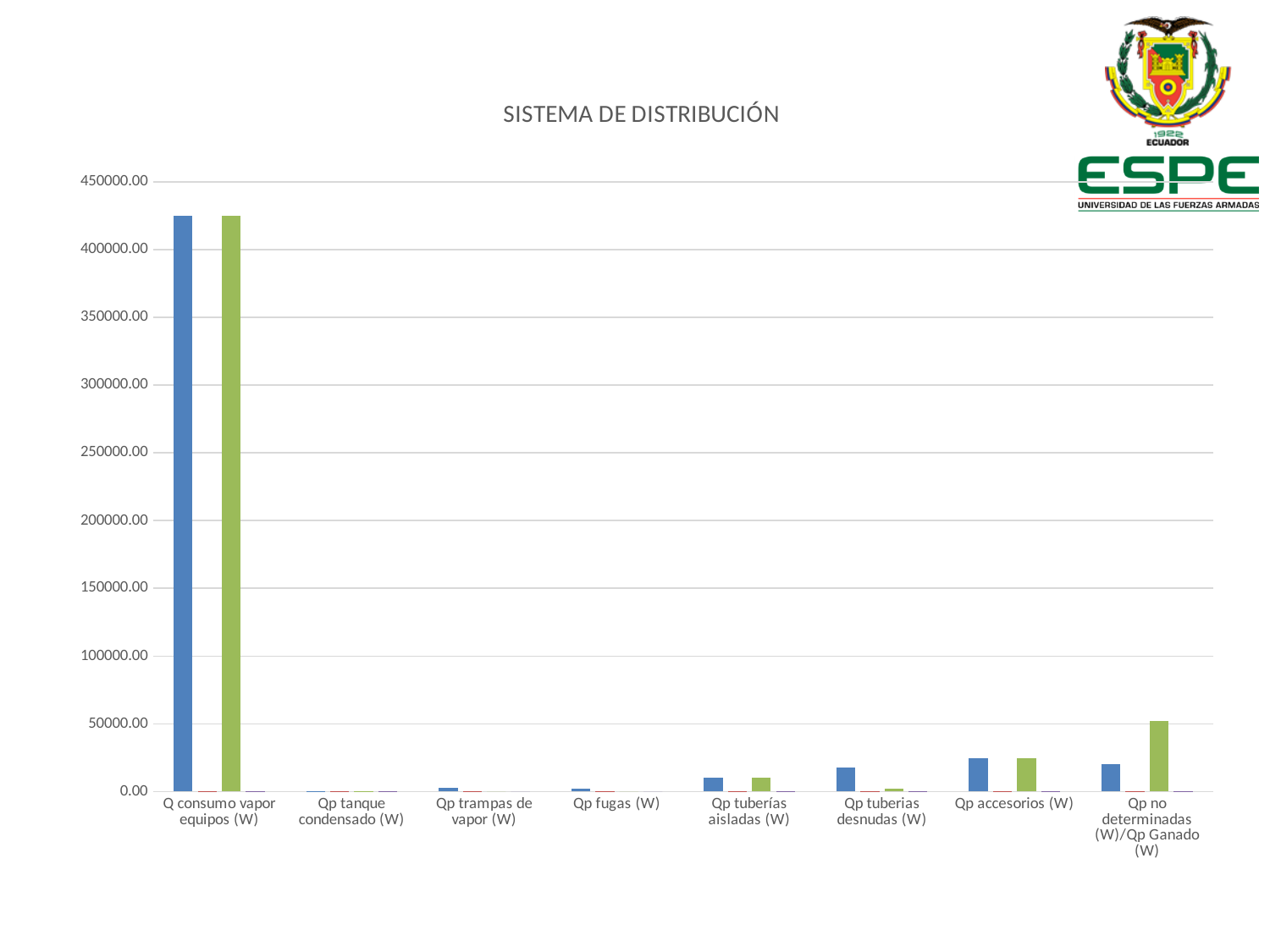
Which is larger: the green bar for Qp no determinadas (W)/Qp Ganado (W) or the green bar for Qp accesorios (W)? Qp no determinadas (W)/Qp Ganado (W) Is the blue bar for Qp accesorios (W) greater or less than 50000.00? less How many categories are shown on the x axis of the chart? 8 Which is larger: the blue bar for Qp accesorios (W) or the blue bar for Qp tuberías aisladas (W)? Qp accesorios (W) Is the green bar for Q consumo vapor equipos (W) greater or less than 400000.00? greater What is the title of the chart? SISTEMA DE DISTRIBUCIÓN Is the blue bar for Qp tuberías aisladas (W) greater or less than 50000.00? less Which category has the highest green bar? Q consumo vapor equipos (W) Which category has the highest blue bar? Q consumo vapor equipos (W) What kind of chart is shown on the slide? bar chart